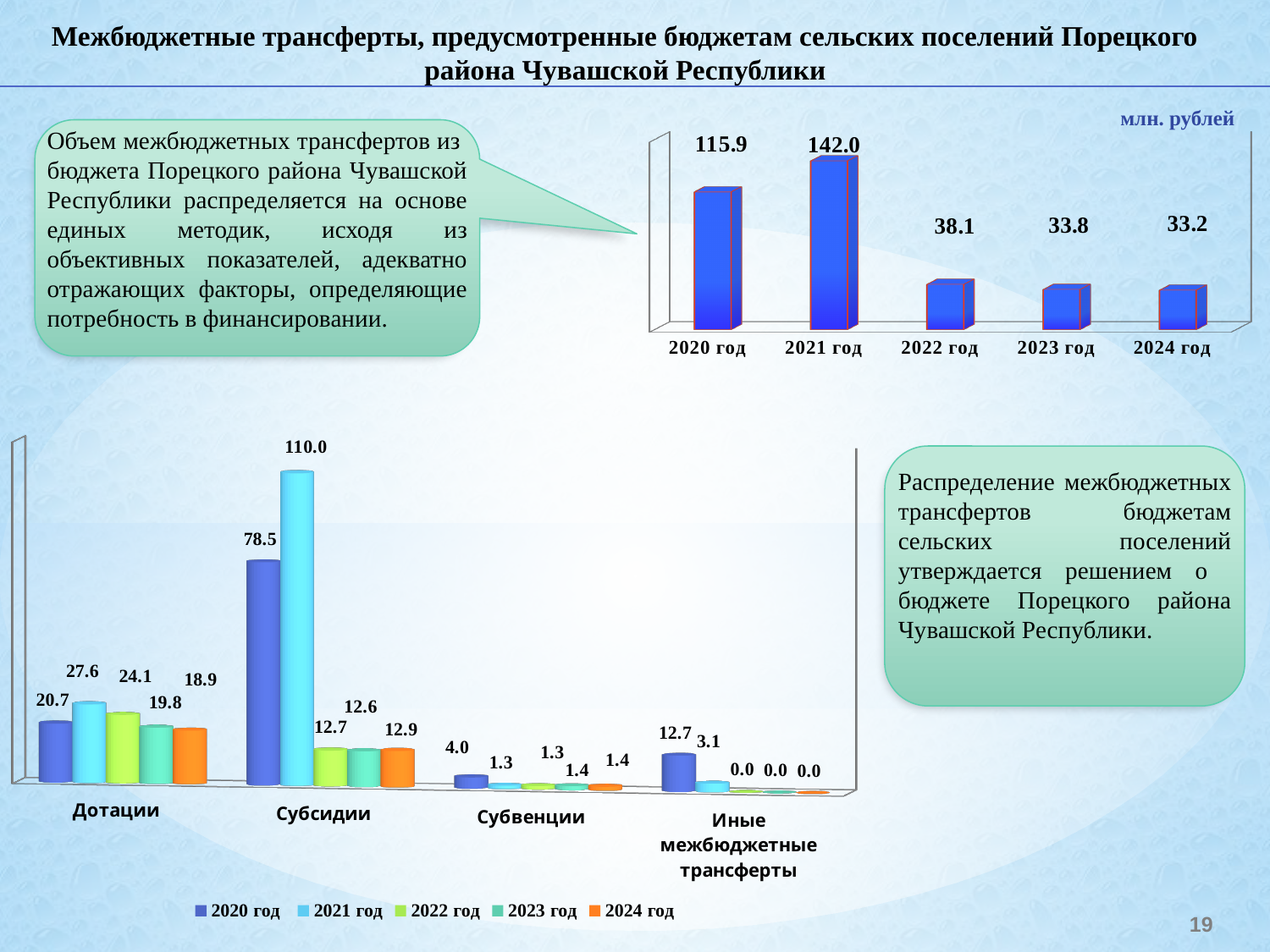
In the top-right chart, how many years are shown? 5 In the bottom-left chart, what is the value for Субсидии in 2021 год? 110.0 In the bottom-left chart, what is the difference between Субсидии in 2021 год and Субсидии in 2020 год? 31.5 In the top-right chart, which year has the highest value? 2021 год In the top-right chart, what is the difference between the values for 2021 год and 2020 год? 26.1 In the top-right chart, which year has the lowest value? 2024 год In the top-right chart, do the values rise or fall from 2022 год to 2024 год? fall In the top-right chart, what is the value for 2021 год? 142.0 In the bottom-left chart, which is larger for Иные межбюджетные трансферты: 2020 год or 2021 год? 2020 год In the bottom-left chart, how many series does the legend list? 5 What kind of chart is the bottom-left chart? bar chart In the bottom-left chart, what is the value for Дотации in 2024 год? 18.9